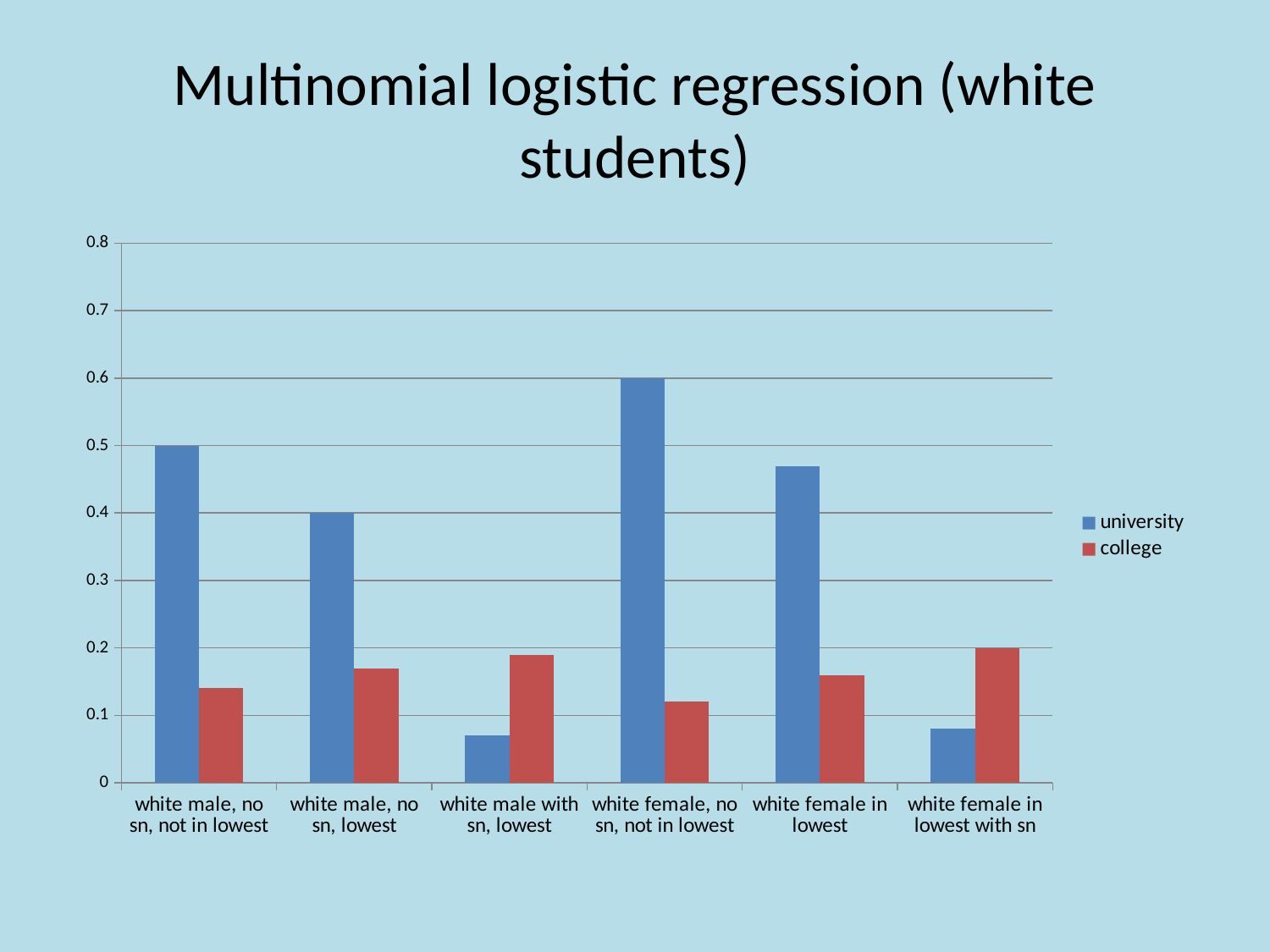
What is the university value for 'white male, no sn, lowest'? 0.4 What kind of chart is shown on the slide? bar chart What is the university value for 'white male, no sn, not in lowest'? 0.5 What colour are the college bars? red What is the university value for 'white female, no sn, not in lowest'? 0.6 Which category has the lowest university value? white male with sn, lowest Which category has the highest university value? white female, no sn, not in lowest How many series does the legend list? 2 For 'white female in lowest with sn', which is larger, the university value or the college value? college How many categories are shown on the x axis? 6 Is the university value for 'white female in lowest' greater or less than 0.4? greater